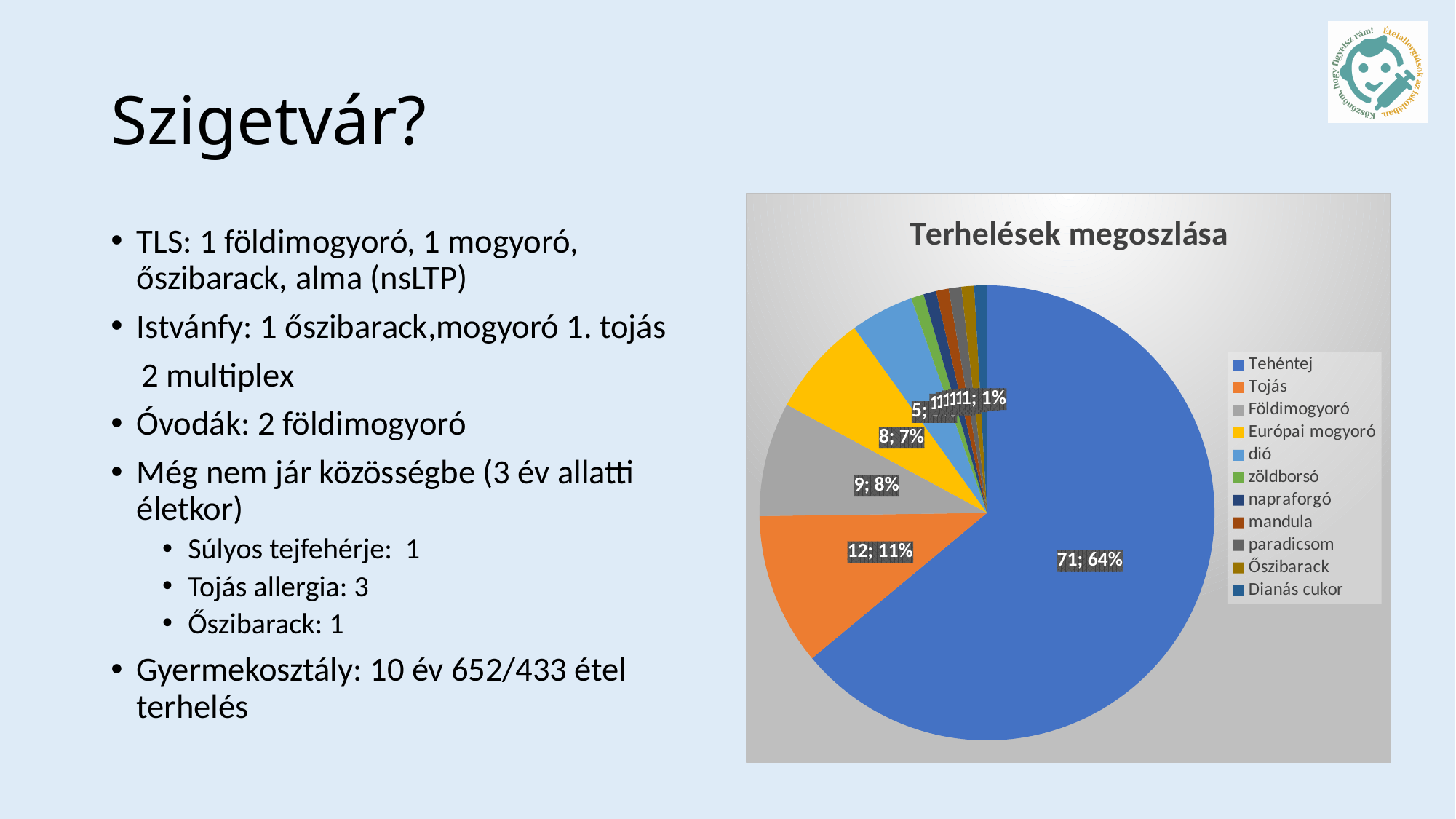
What kind of chart is shown on the slide? pie chart What share of the pie does Európai mogyoró represent? 7% Which is larger, the value for Földimogyoró or the value for Európai mogyoró? Földimogyoró What is the value shown for Tojás? 12 What share of the pie does Tehéntej represent? 64% What is the value shown for Tehéntej? 71 What is the value shown for Földimogyoró? 9 What is the difference between the values for Tehéntej and Tojás? 59 What is the title of the chart? Terhelések megoszlása What share of the pie does Tojás represent? 11% How many categories does the chart's legend list? 11 Which category has the largest slice of the pie? Tehéntej